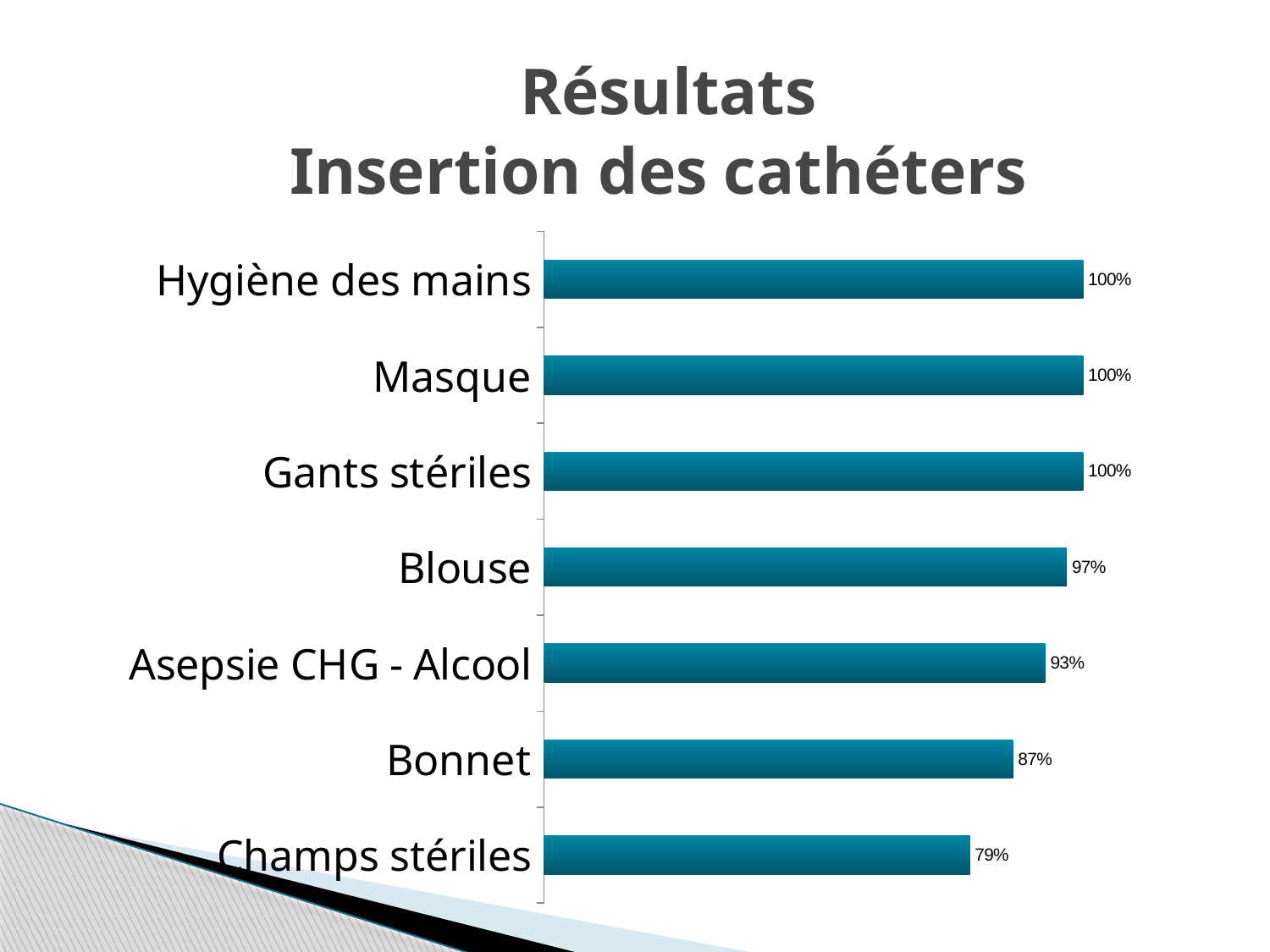
What is the difference between the values for Blouse and Champs stériles? 18% Which is larger, the value for Bonnet or the value for Asepsie CHG - Alcool? Asepsie CHG - Alcool What kind of chart is shown on the slide? Bar chart What is the value for Asepsie CHG - Alcool? 93% How many categories have a value of 100%? 3 What is the title of the slide? Résultats Insertion des cathéters Which category has the lowest value? Champs stériles What is the value for Bonnet? 87% What is the difference between the values for Asepsie CHG - Alcool and Bonnet? 6% What is the value for Blouse? 97% How many categories are shown in the chart? 7 What is the value for Champs stériles? 79%